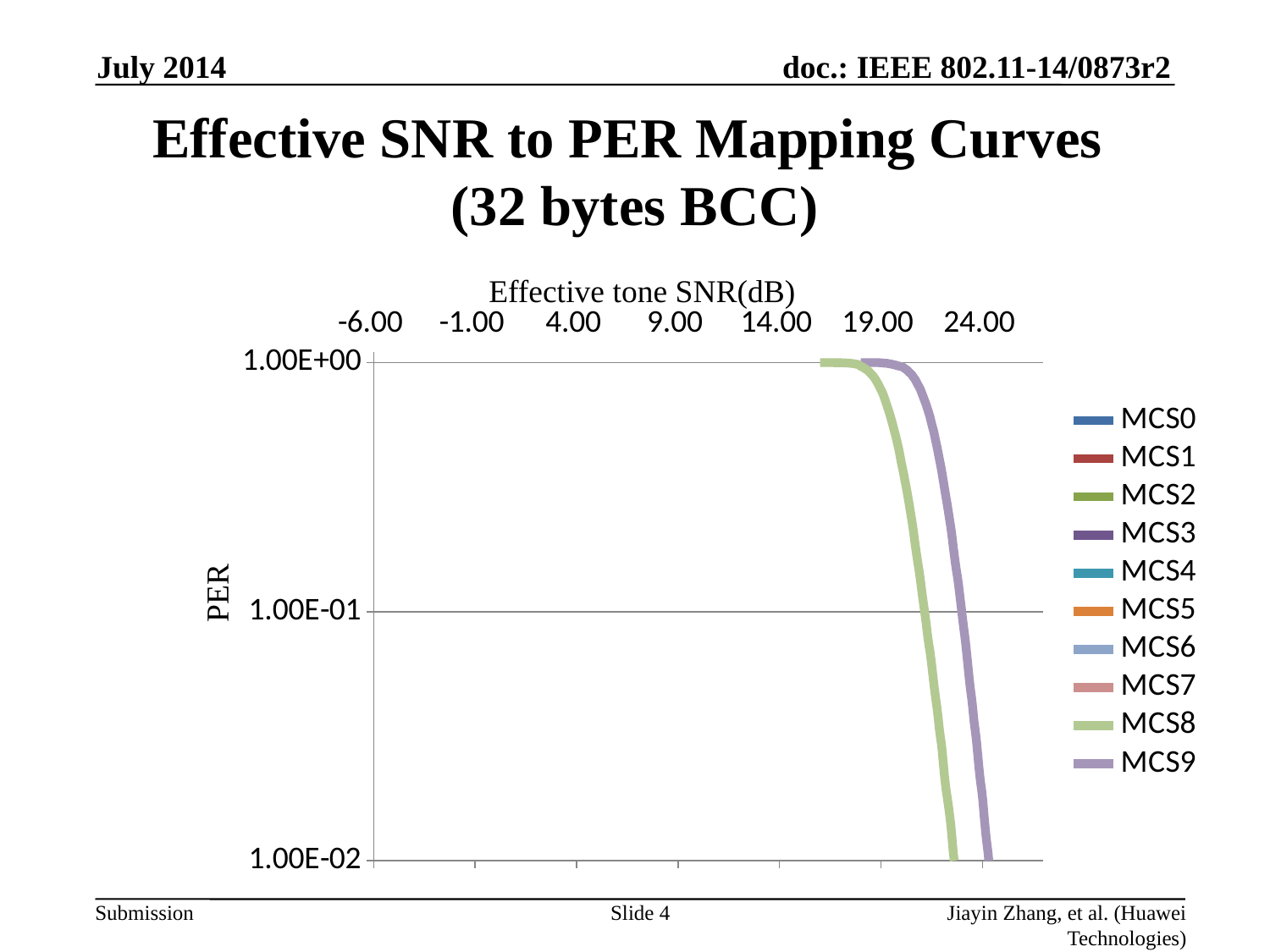
Is the PER for MCS9 at an effective tone SNR of 19.00 dB greater or less than 1.00E-01? greater How many curves are actually visible in the plot area? 2 What is the title of the chart's y axis? PER How many series does the legend list? 10 What is the title of the chart's x axis? Effective tone SNR(dB) Which curve reaches a PER of 1.00E-02 at a lower SNR, MCS8 or MCS9? MCS8 Is the PER for MCS8 at an effective tone SNR of 19.00 dB greater or less than 1.00E-01? greater What kind of chart is shown on the slide? line chart What is the lowest PER value labelled on the y axis? 1.00E-02 As the effective tone SNR increases along the x axis, does the PER for MCS8 rise or fall? fall Which curve reaches a PER of 1.00E-01 at a higher SNR, MCS8 or MCS9? MCS9